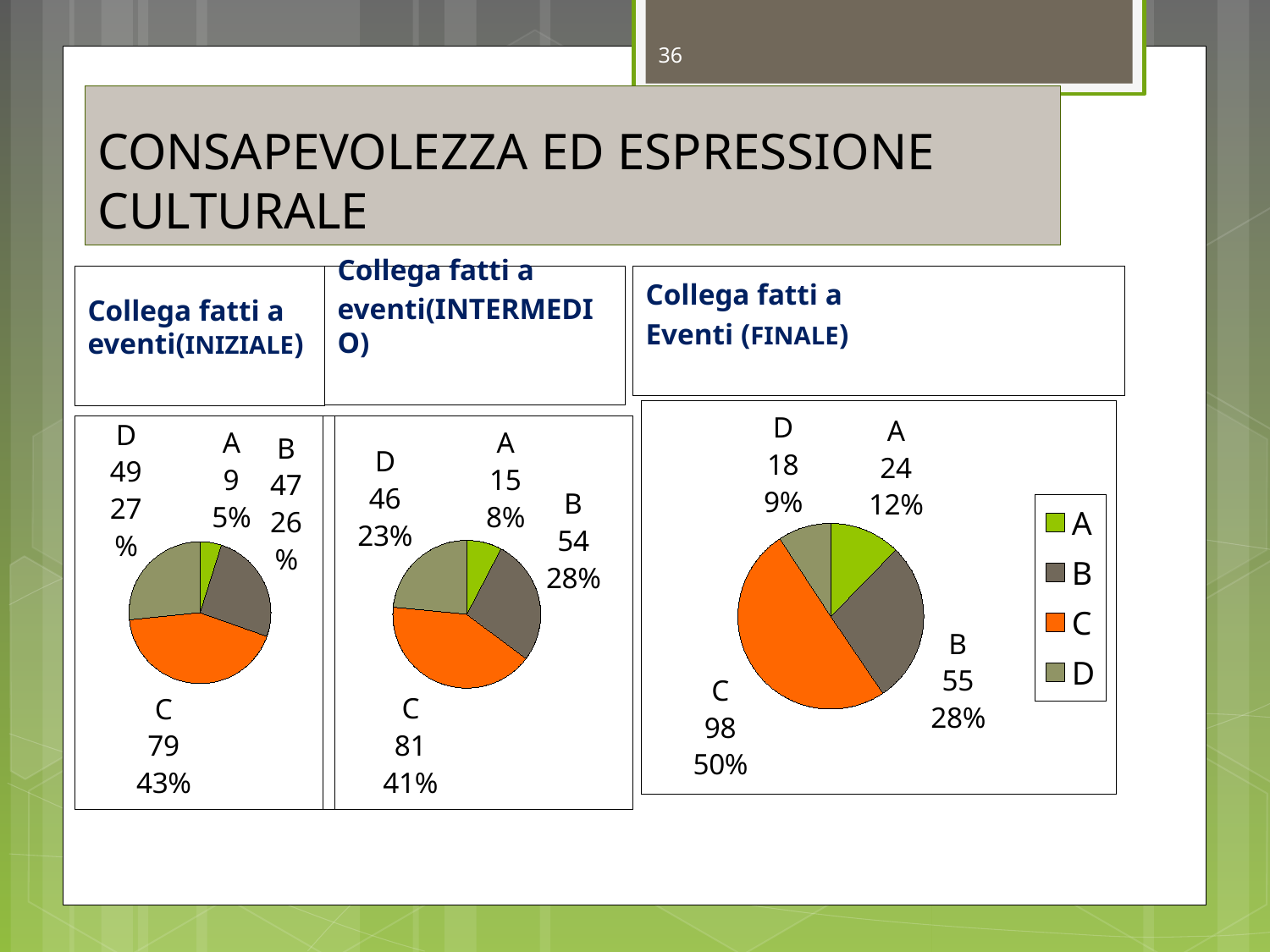
In the INIZIALE pie chart (left), which category has the lowest value? A In the FINALE pie chart (right), what is the difference between the values for B and D? 37 In the FINALE pie chart (right), what is the value for category C? 98 In the FINALE pie chart (right), which is larger, the value for A or the value for D? A What type of chart is used in the INIZIALE panel (left)? Pie chart In the INTERMEDIO pie chart (middle), what is the value for category B? 54 In the FINALE pie chart (right), what share of the pie does category A represent? 12% In the INTERMEDIO pie chart (middle), what share of the pie does category D represent? 23% In the INIZIALE pie chart (left), what share of the pie does category A represent? 5% How many categories does the legend of the FINALE pie chart (right) list? 4 In the INIZIALE pie chart (left), what is the value for category C? 79 In the INTERMEDIO pie chart (middle), which category has the highest value? C